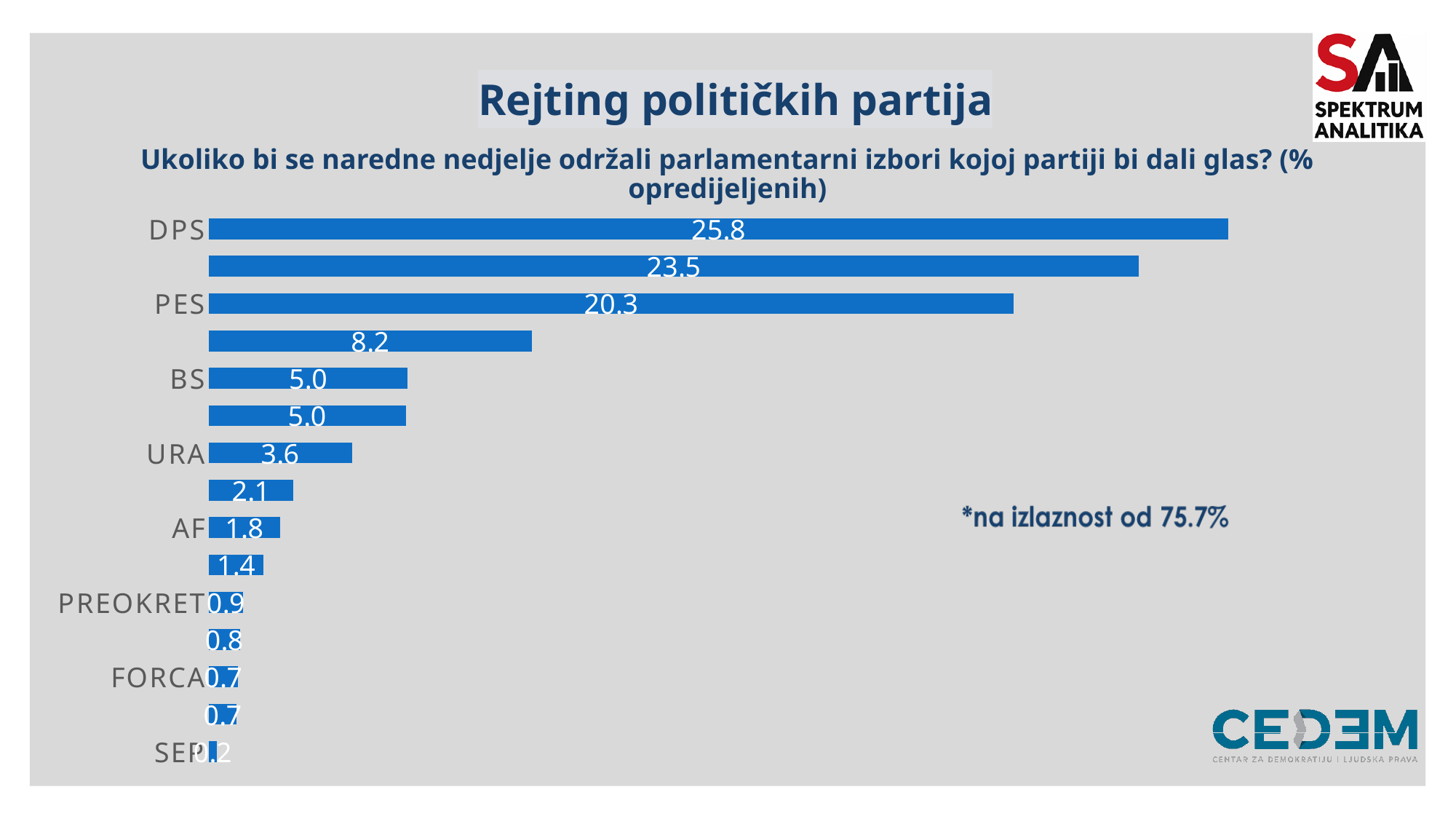
Which party has the lowest value? SEP What is the value for PES? 20.3 What is the title of the slide? Rejting političkih partija Which is larger, the value for URA or the value for AF? URA What is the value for DPS? 25.8 What is the value for BS? 5.0 Which party has the highest value? DPS What is the value for PREOKRET? 0.9 What kind of chart is shown on the slide? bar chart What is the value for URA? 3.6 How many bars are plotted in the chart? 15 What is the difference between the values for DPS and PES? 5.5